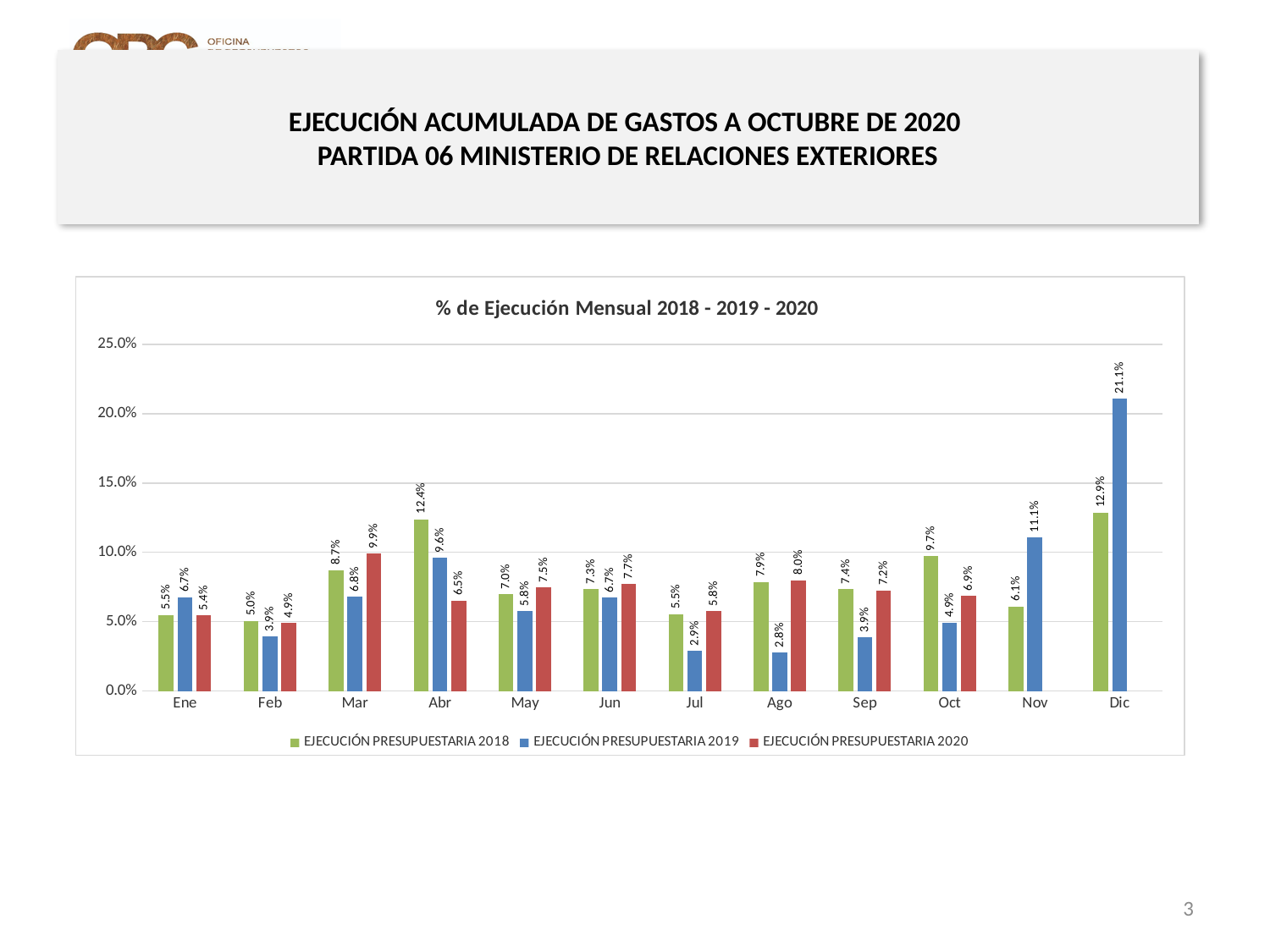
What is the value for EJECUCIÓN PRESUPUESTARIA 2020 in Mar? 9.9% What is the title of the chart? % de Ejecución Mensual 2018 - 2019 - 2020 How many months are shown on the x axis? 12 Is the value for EJECUCIÓN PRESUPUESTARIA 2019 in Dic greater or less than 20.0%? greater What is the value for EJECUCIÓN PRESUPUESTARIA 2018 in Abr? 12.4% What is the value for EJECUCIÓN PRESUPUESTARIA 2019 in Dic? 21.1% In Oct, which is larger: EJECUCIÓN PRESUPUESTARIA 2018 or EJECUCIÓN PRESUPUESTARIA 2020? EJECUCIÓN PRESUPUESTARIA 2018 What kind of chart is shown on the slide? Bar chart What is the difference between EJECUCIÓN PRESUPUESTARIA 2019 and EJECUCIÓN PRESUPUESTARIA 2018 in Dic? 8.2% Which month has the lowest value for EJECUCIÓN PRESUPUESTARIA 2019? Ago How many series does the legend list? 3 Which month has the highest value for EJECUCIÓN PRESUPUESTARIA 2018? Dic